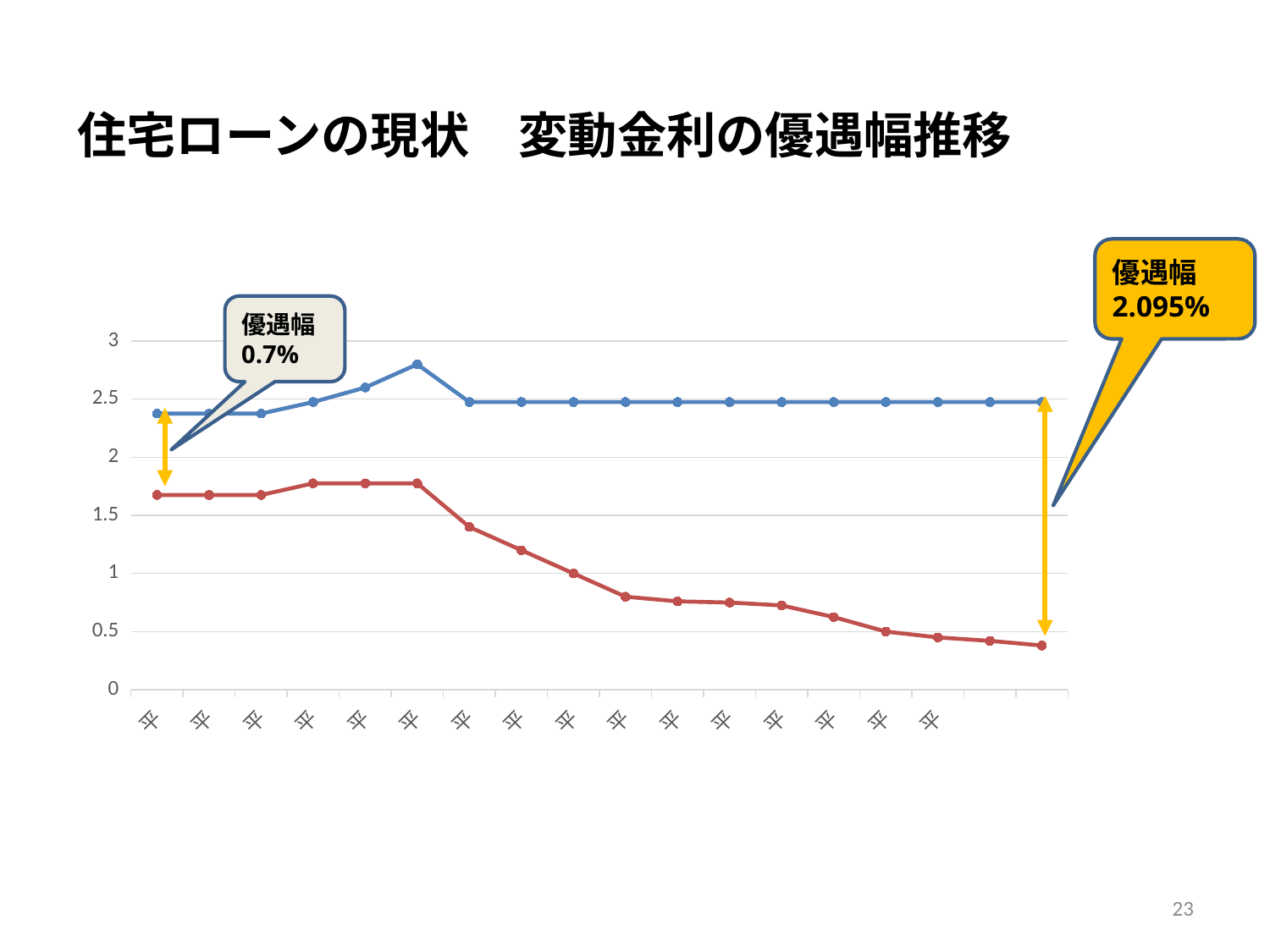
Is the highest point of the blue line greater or less than 2.5? greater Is the value of the red line at the last point greater or less than 0.5? less How many data points does the blue line have? 18 What is the title of the chart on the slide? 住宅ローンの現状 変動金利の優遇幅推移 Is the value of the red line at the first point greater or less than 1.5? greater How many lines (series) are plotted in the chart? 2 Does the red line rise or fall overall from left to right along the x axis? fall At the last data point, which line has the higher value, the blue line or the red line? blue line What 優遇幅 value does the callout at the right (end) of the chart show? 2.095% What 優遇幅 value does the callout at the left (start) of the chart show? 0.7% What kind of chart is shown on the slide? line chart